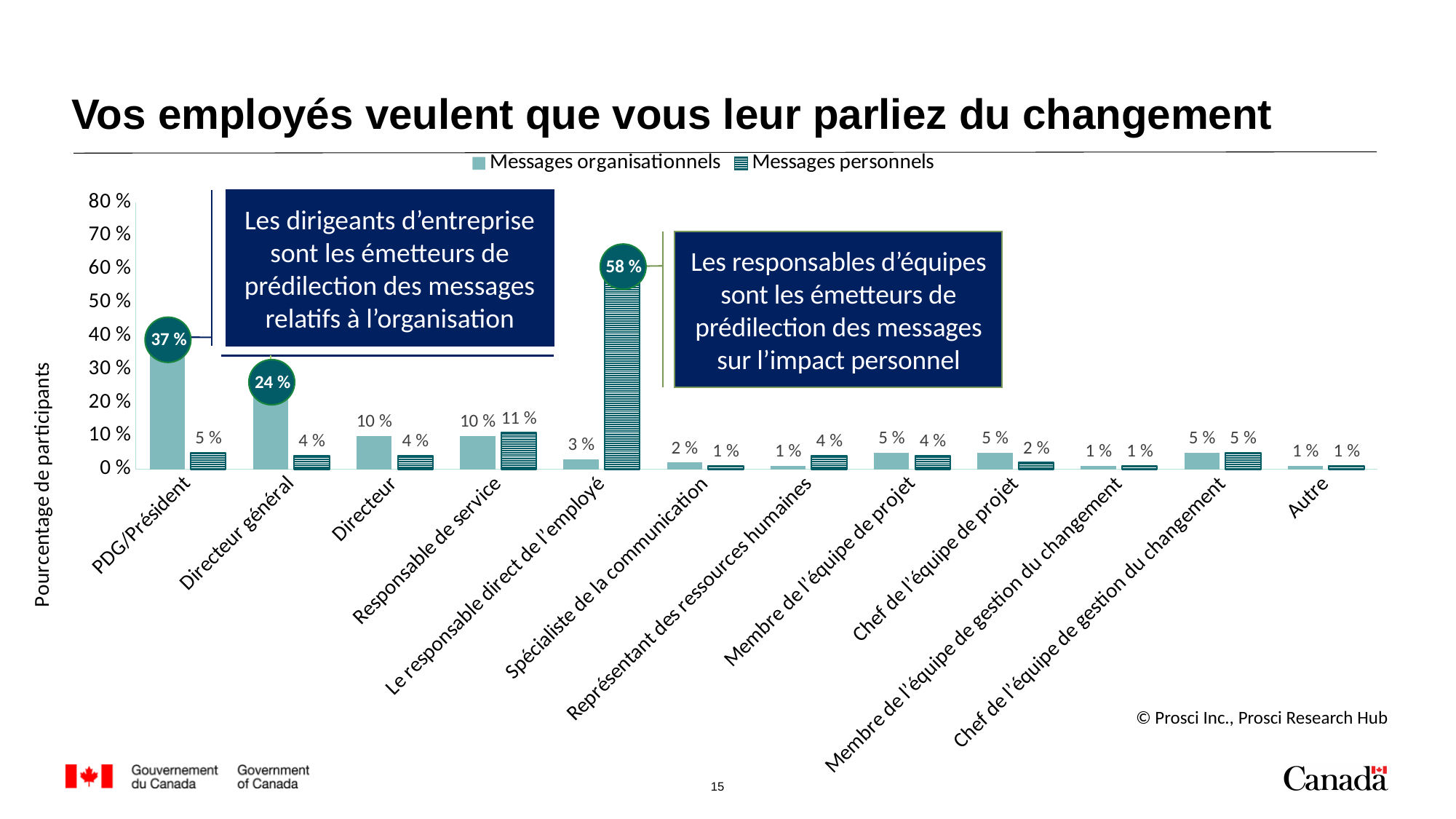
How many categories are shown on the x axis? 12 What is the difference between Messages organisationnels and Messages personnels for PDG/Président? 32 % For Représentant des ressources humaines, which is larger: Messages organisationnels or Messages personnels? Messages personnels Which category has the highest value for Messages organisationnels? PDG/Président What is the value for Messages personnels for Le responsable direct de l'employé? 58 % What kind of chart is shown on the slide? Bar chart Which category has the highest value for Messages personnels? Le responsable direct de l'employé What is the value for Messages organisationnels for PDG/Président? 37 % What is the value for Messages organisationnels for Directeur général? 24 % What is the value for Messages personnels for Responsable de service? 11 % How many series does the legend list? 2 What is the label of the y axis? Pourcentage de participants